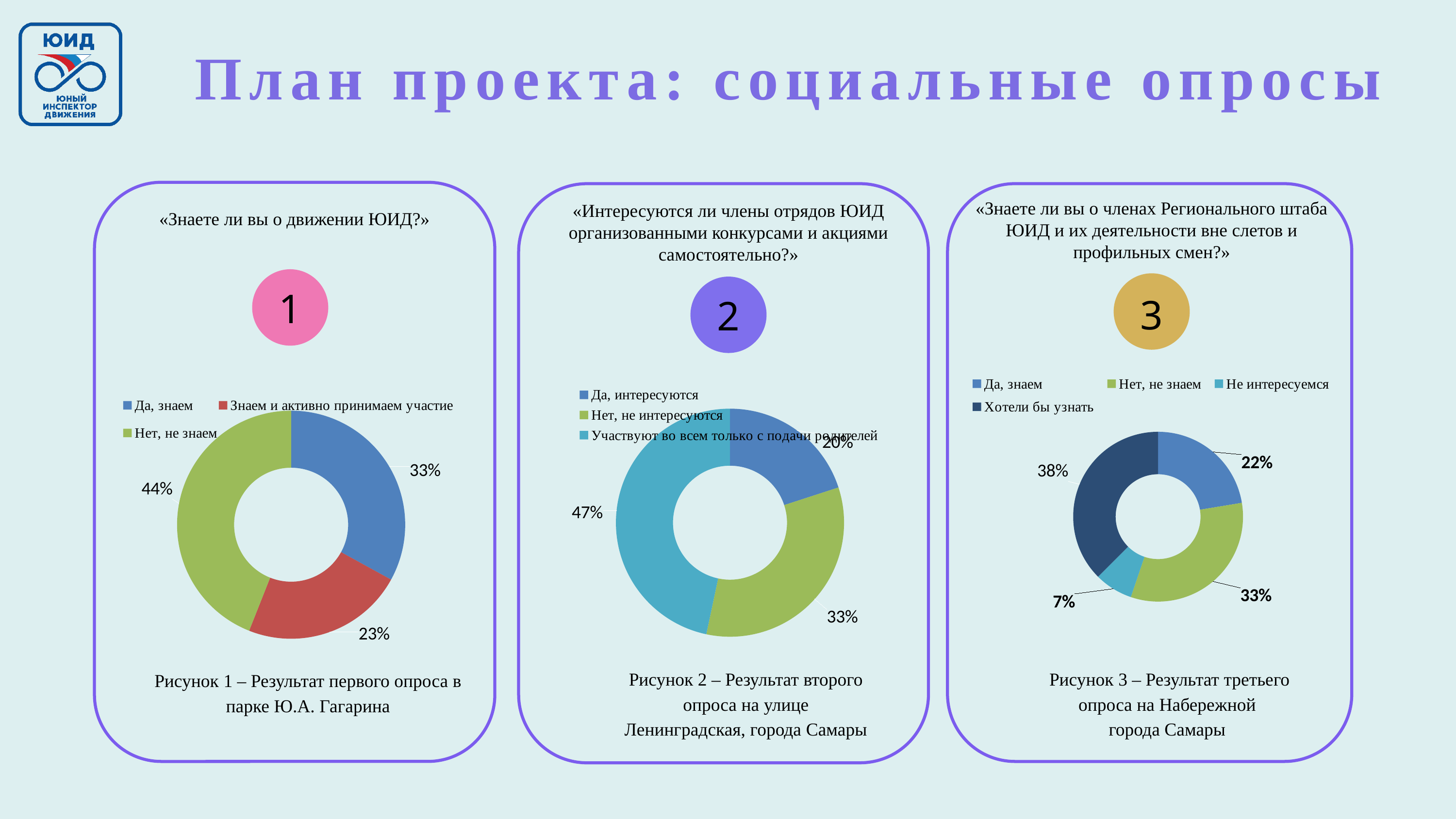
In the left chart (Рисунок 1), which category has the largest share? Нет, не знаем In the middle chart (Рисунок 2), what share answered «Участвуют во всем только с подачи родителей»? 47% In the left chart (Рисунок 1, «Знаете ли вы о движении ЮИД?»), what share of respondents answered «Нет, не знаем»? 44% In the left chart (Рисунок 1), what is the value for «Знаем и активно принимаем участие»? 23% In the right chart (Рисунок 3), how many categories are shown? 4 In the right chart (Рисунок 3), which is larger: «Да, знаем» or «Нет, не знаем»? Нет, не знаем In the right chart (Рисунок 3), which category has the smallest share? Не интересуемся In the right chart (Рисунок 3), what is the value for «Хотели бы узнать»? 38% What type of chart is used in all three figures on the slide? Doughnut (pie) chart In the middle chart (Рисунок 2), how many categories does the legend list? 3 In the middle chart (Рисунок 2), which category has the smallest share? Да, интересуются In the left chart (Рисунок 1), what is the difference between «Да, знаем» and «Знаем и активно принимаем участие»? 10%